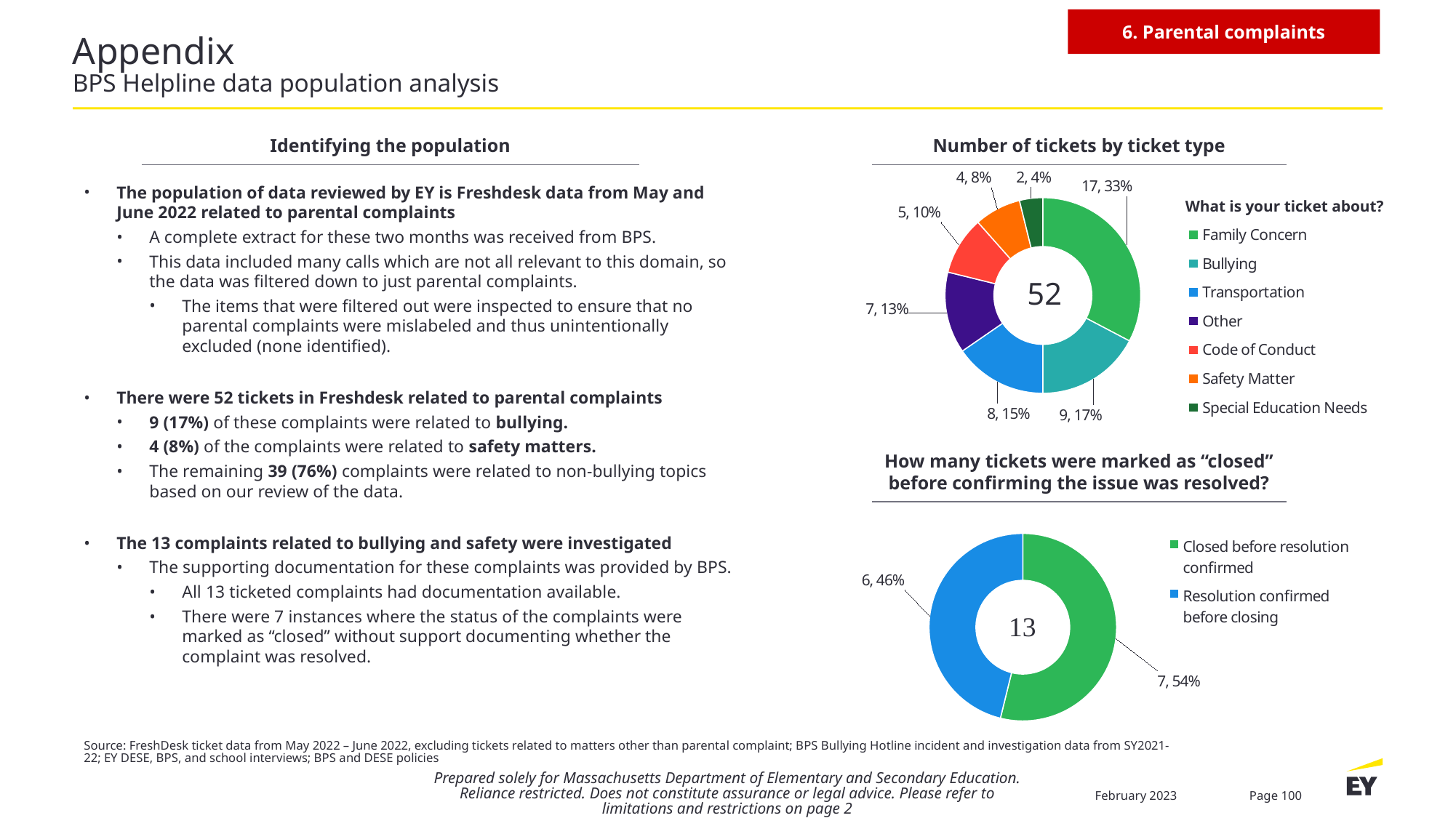
In the chart 'How many tickets were marked as "closed" before confirming the issue was resolved?', how many series does the legend list? 2 In the 'Number of tickets by ticket type' chart, how many tickets are Family Concern? 17 In the chart 'How many tickets were marked as "closed" before confirming the issue was resolved?', what share of tickets had resolution confirmed before closing? 46% In the 'Number of tickets by ticket type' chart, how many ticket types are shown? 7 In the chart 'How many tickets were marked as "closed" before confirming the issue was resolved?', how many tickets were closed before resolution was confirmed? 7 In the 'Number of tickets by ticket type' chart, which ticket type has the fewest tickets? Special Education Needs What type of chart is used for 'Number of tickets by ticket type'? Donut (pie) chart What is the total number of tickets shown in the centre of the 'Number of tickets by ticket type' chart? 52 In the 'Number of tickets by ticket type' chart, what share of tickets is Bullying? 17% In the 'Number of tickets by ticket type' chart, how many more tickets are Transportation than Safety Matter? 4 In the 'Number of tickets by ticket type' chart, which has more tickets, Other or Code of Conduct? Other In the 'Number of tickets by ticket type' chart, which ticket type has the most tickets? Family Concern